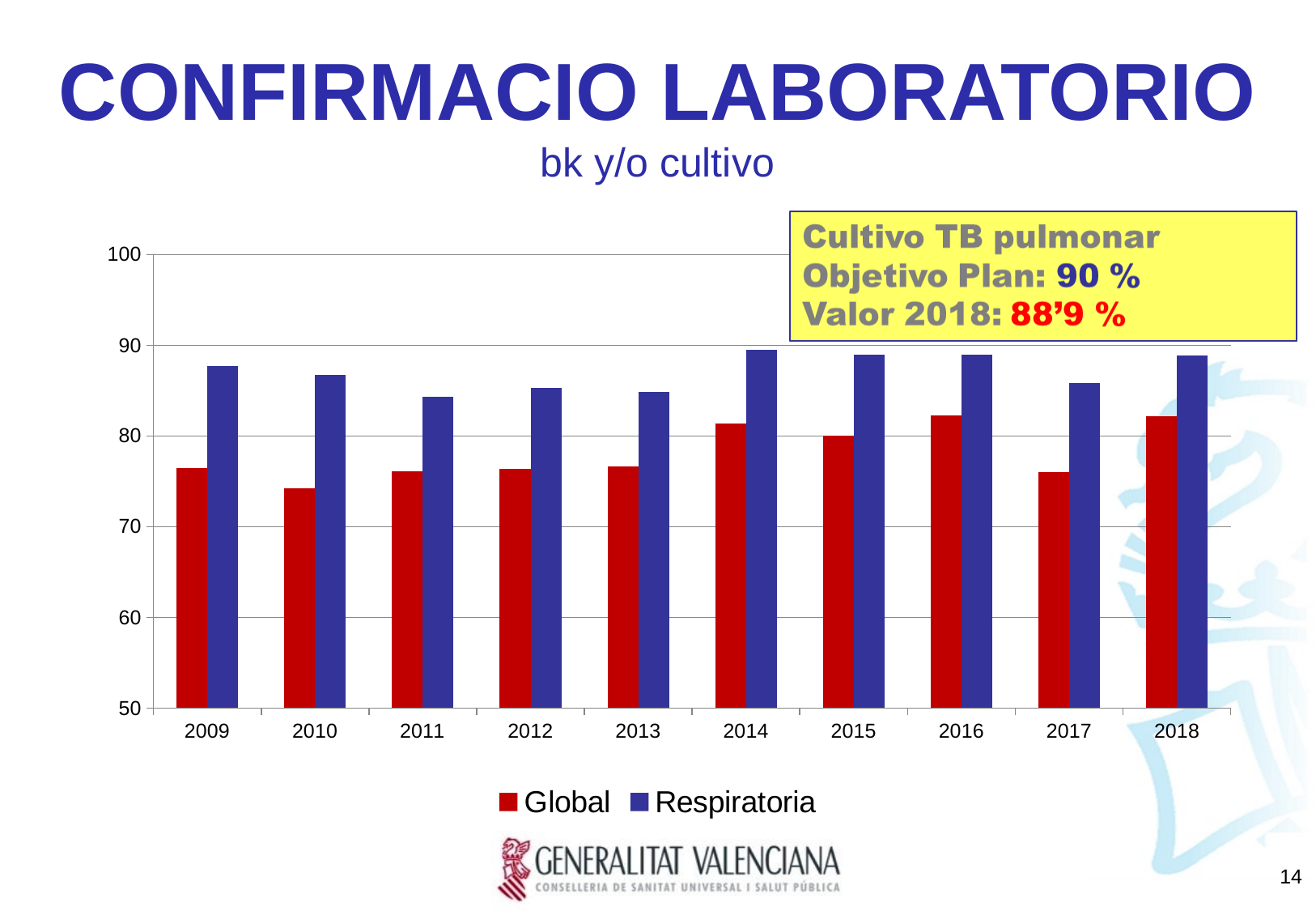
For the Global series, which is larger, the value for 2014 or the value for 2010? 2014 What kind of chart is shown on the slide? bar chart Which series is shown in red in the legend? Global Is the Global value for 2010 greater or less than 80? less In 2018, which series has the larger value, Global or Respiratoria? Respiratoria Which year has the lowest value for the Global series? 2010 How many series does the legend list? 2 According to the text box on the slide, what is the Valor 2018 for Cultivo TB pulmonar? 88'9 % How many years are shown on the x axis? 10 Is the Global value for 2014 greater or less than 80? greater Is the Respiratoria value for 2011 greater or less than 80? greater